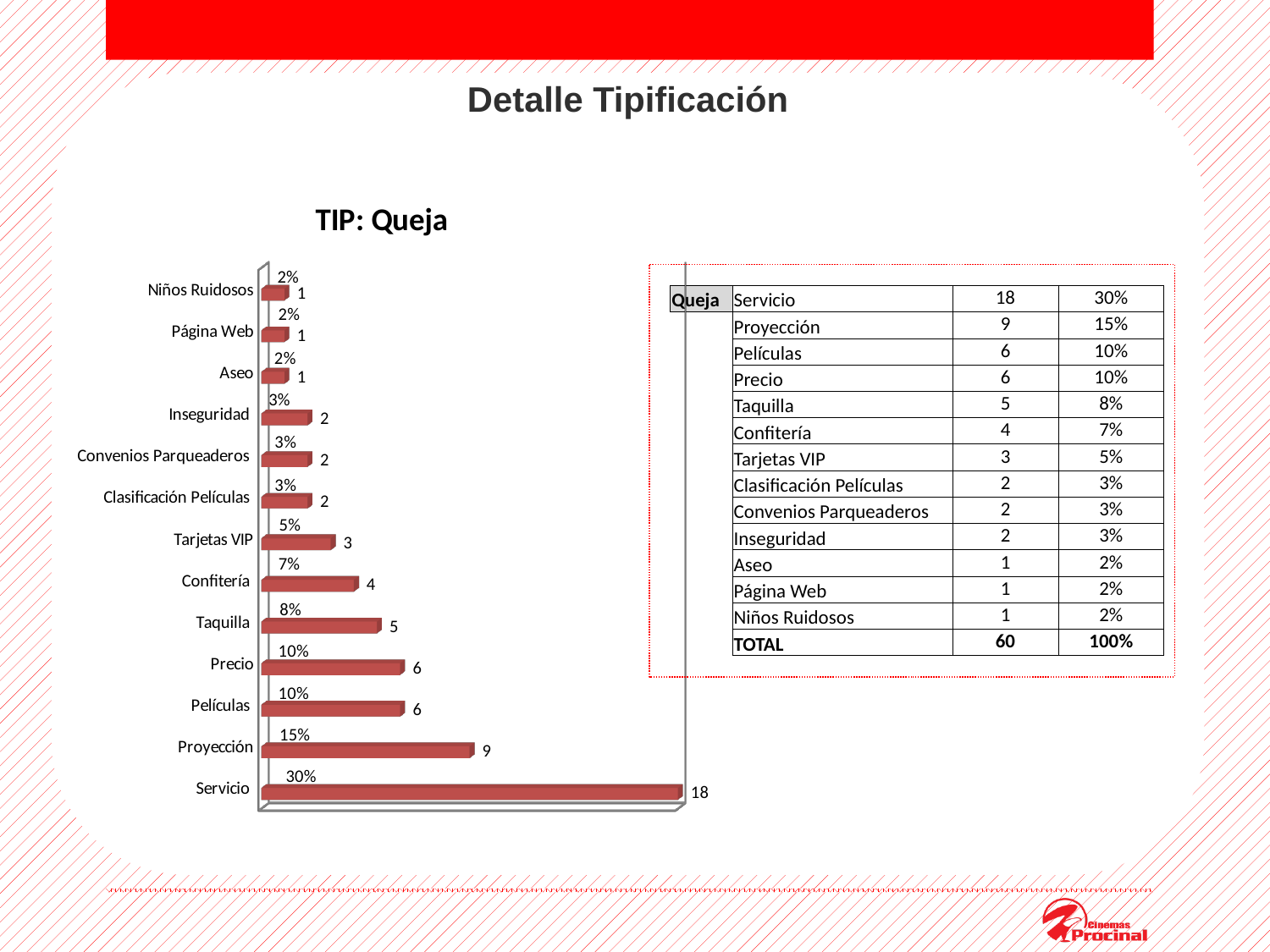
What is the difference between the values for Servicio and Proyección in the TIP: Queja chart? 9 What is the value for Taquilla in the TIP: Queja chart? 5 How many categories are plotted in the TIP: Queja chart? 13 What percentage is shown for Aseo in the TIP: Queja chart? 2% What percentage is shown for Proyección in the TIP: Queja chart? 15% Which category has the highest value in the TIP: Queja chart? Servicio Which is larger in the TIP: Queja chart, the value for Confitería or the value for Tarjetas VIP? Confitería What percentage is shown for Confitería in the TIP: Queja chart? 7% What is the value for Servicio in the TIP: Queja chart? 18 What kind of chart is the TIP: Queja chart? Bar chart What is the difference between the values for Precio and Inseguridad in the TIP: Queja chart? 4 What is the title of the chart on the slide? TIP: Queja